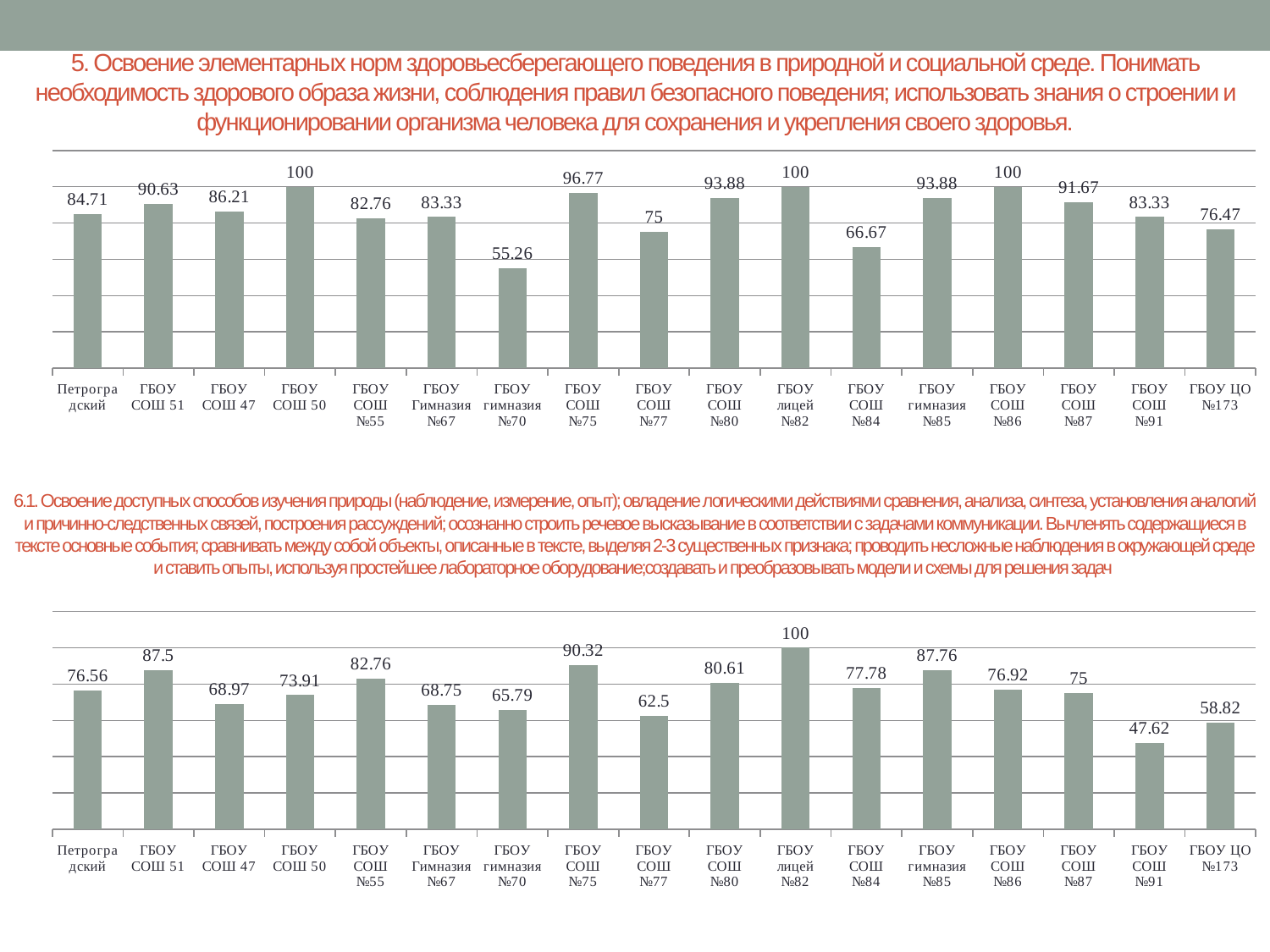
In the bottom chart, what is the value for ГБОУ СОШ №91? 47.62 In the top chart, what is the value for ГБОУ СОШ №75? 96.77 What type of chart is the top chart? Bar chart In the bottom chart, what is the difference between the values for ГБОУ СОШ №75 and ГБОУ СОШ №77? 27.82 In the bottom chart, what is the value for ГБОУ гимназия №85? 87.76 In the top chart, which category has the lowest value? ГБОУ гимназия №70 In the top chart, what is the difference between the values for ГБОУ СОШ 51 and Петроградский? 5.92 In the top chart, what is the value for ГБОУ СОШ №84? 66.67 In the bottom chart, which category has the highest value? ГБОУ лицей №82 In the bottom chart, which category has the lowest value? ГБОУ СОШ №91 In the top chart, which is larger: the value for ГБОУ СОШ №80 or the value for ГБОУ СОШ №87? ГБОУ СОШ №80 How many categories are shown in the bottom chart? 17